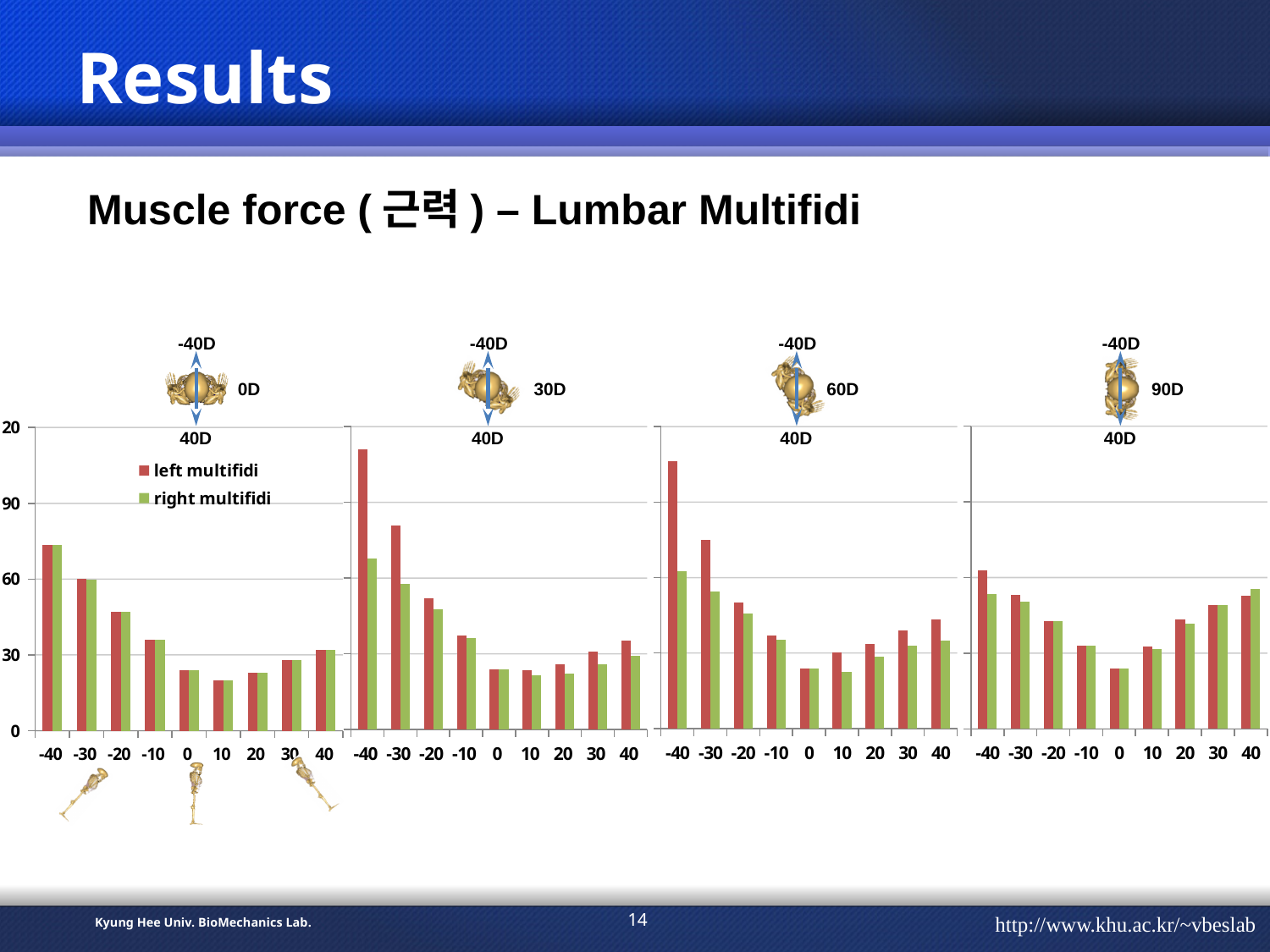
What colour are the left multifidi bars in the charts? red In the 30D chart, which is larger at -40, left multifidi or right multifidi? left multifidi In the 0D chart, at which x-axis category is the left multifidi value highest? -40 How many x-axis categories does the 30D chart have? 9 How many series does the legend on the 0D chart list? 2 In the 60D chart, is the left multifidi value at 0 greater or less than 30? less In the 30D chart, is the left multifidi value at -40 greater or less than 90? greater In the 90D chart, is the right multifidi value at 40 greater or less than 60? less In the 0D chart, at which x-axis category is the left multifidi value lowest? 10 In the 0D chart, do the left multifidi values rise or fall from -40 to 10 along the x axis? fall In the 60D chart, which is larger at -30, left multifidi or right multifidi? left multifidi What kind of chart is the 0D chart? bar chart